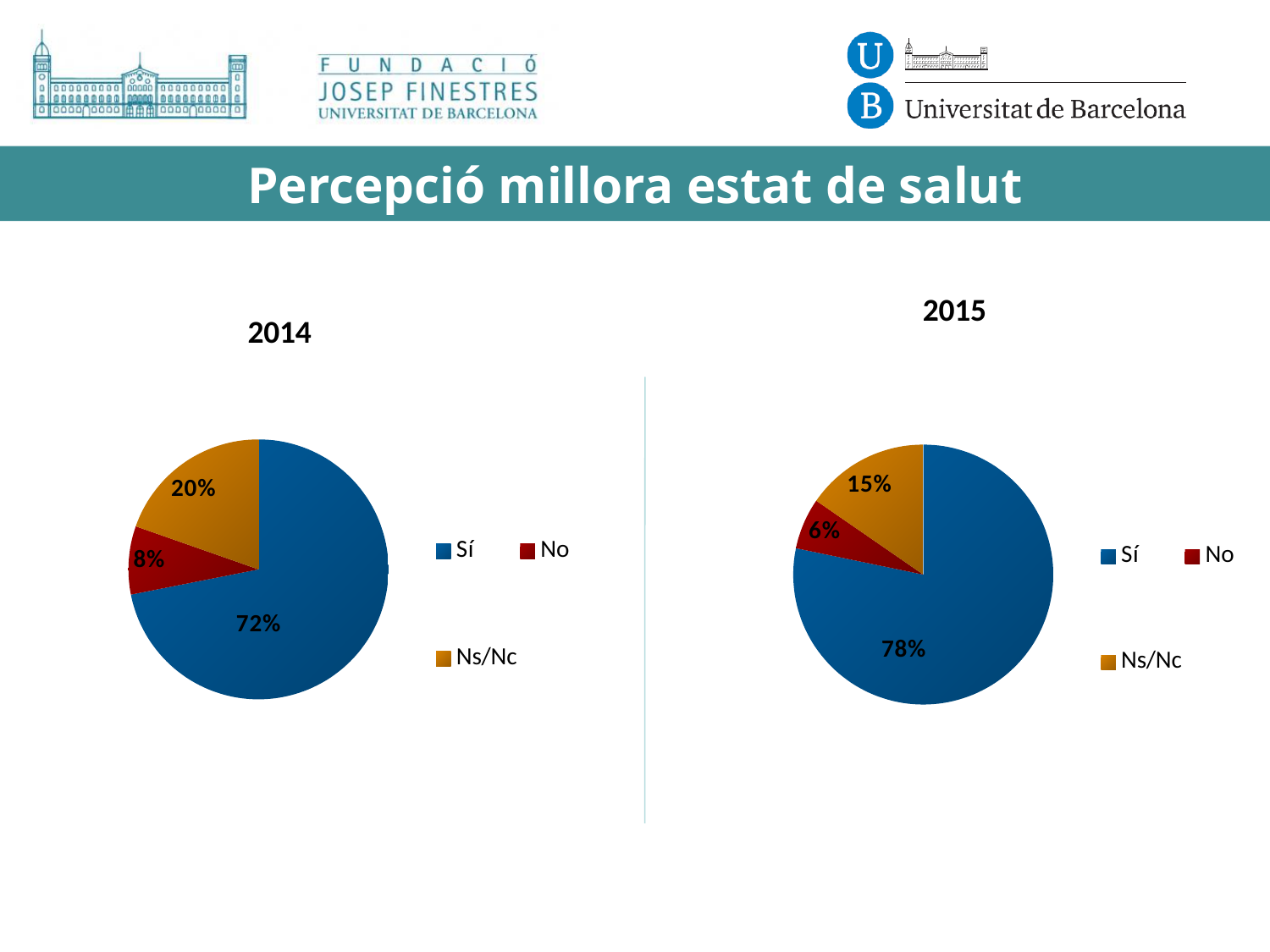
How many entries does the legend of the 2014 pie chart list? 3 How many slices does the 2015 pie chart have? 3 What is the difference between the Sí share in 2015 and the Sí share in 2014? 6% Which is larger: the No share in 2014 or the No share in 2015? 2014 What kind of chart is used for the 2014 data? Pie chart In the 2014 pie chart, what share is labelled for No? 8% In the 2014 pie chart, what is the difference between the Ns/Nc share and the No share? 12% In the 2015 pie chart, what share is labelled for Ns/Nc? 15% In the 2014 pie chart, which category has the smallest slice? No What colour is the Ns/Nc slice in the 2015 pie chart? Orange In the 2014 pie chart, what share is labelled for Sí? 72% In the 2015 pie chart, which category has the largest slice? Sí